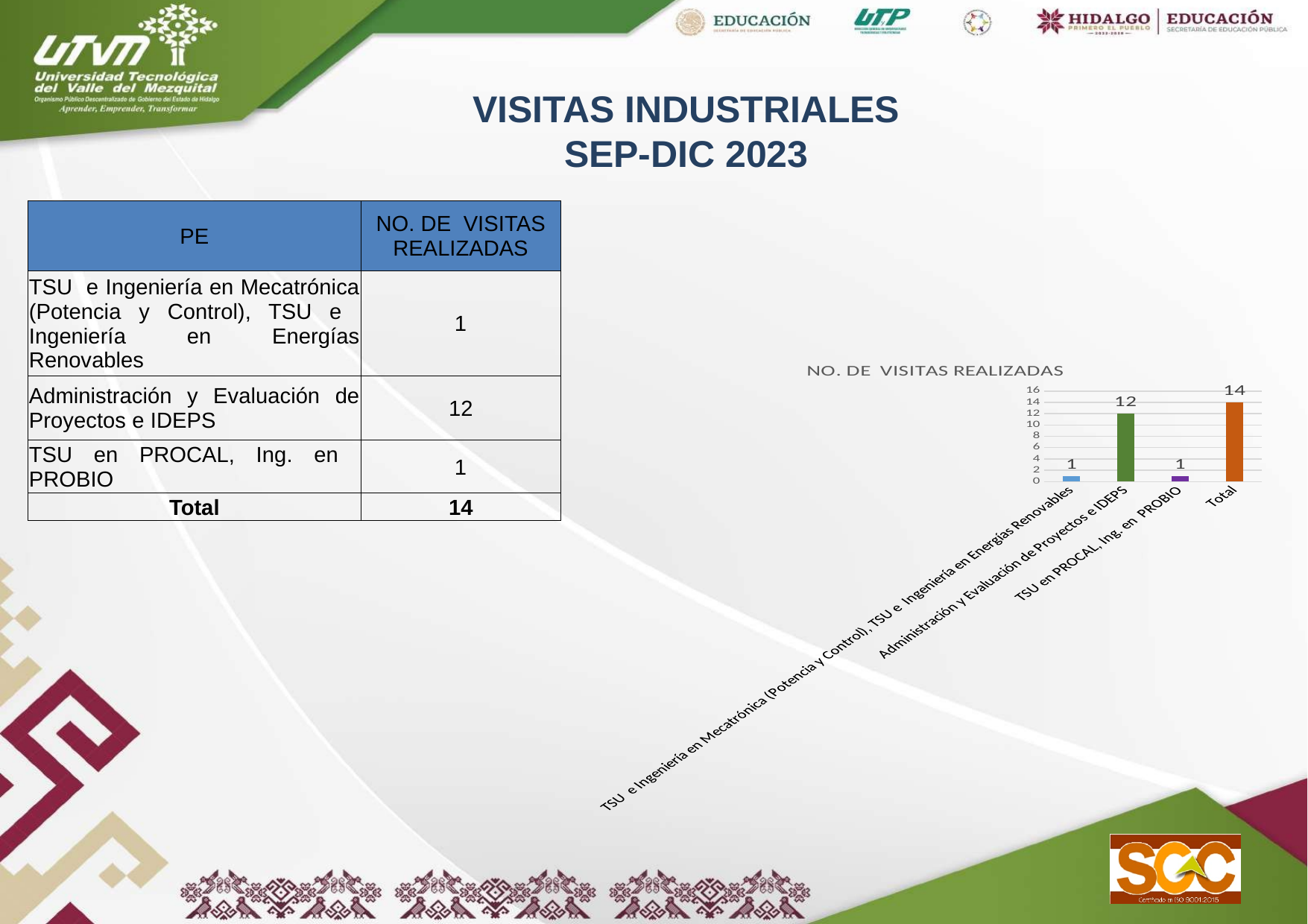
What is the difference between the Total bar and the Administración y Evaluación de Proyectos e IDEPS bar? 2 Is the value for Administración y Evaluación de Proyectos e IDEPS greater or less than 10? greater What is the maximum value shown on the chart's vertical axis? 16 What is the value for Total in the chart? 14 Excluding the Total bar, which category has the highest value in the chart? Administración y Evaluación de Proyectos e IDEPS Which is larger: the value for Administración y Evaluación de Proyectos e IDEPS or the value for TSU en PROCAL, Ing. en PROBIO? Administración y Evaluación de Proyectos e IDEPS Which category has the highest value in the chart? Total How many bars are shown in the chart? 4 What is the title of the chart? NO. DE VISITAS REALIZADAS What is the value for Administración y Evaluación de Proyectos e IDEPS in the chart? 12 What is the value for TSU en PROCAL, Ing. en PROBIO in the chart? 1 What kind of chart is shown on the slide? bar chart